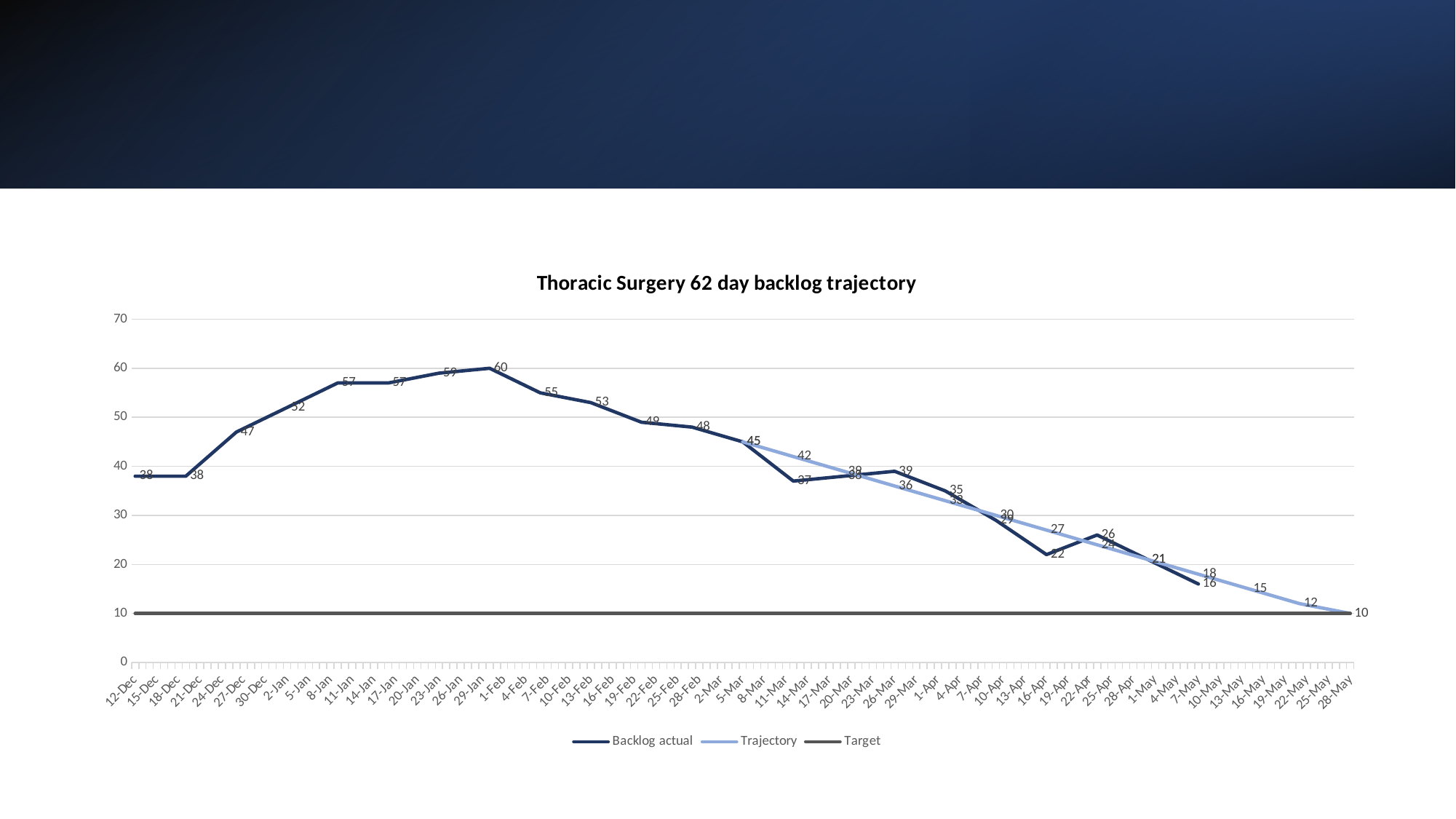
Does the Backlog actual line rise or fall between 1-Feb and 7-May? fall What is the final value labelled on the Trajectory line, at 28-May? 10 What kind of chart is shown on the slide? line chart What is the difference between the peak Backlog actual value and its final labelled value? 44 How many series does the legend list? 3 What is the value of the Target line? 10 What is the first value labelled on the Backlog actual line, at 12-Dec? 38 What is the lowest value labelled on the Backlog actual line? 16 At 7-May, which is larger: the Backlog actual value or the Trajectory value? Trajectory What is the highest value labelled on the Backlog actual line? 60 Which series is drawn in the lighter blue colour? Trajectory What is the title of the chart? Thoracic Surgery 62 day backlog trajectory